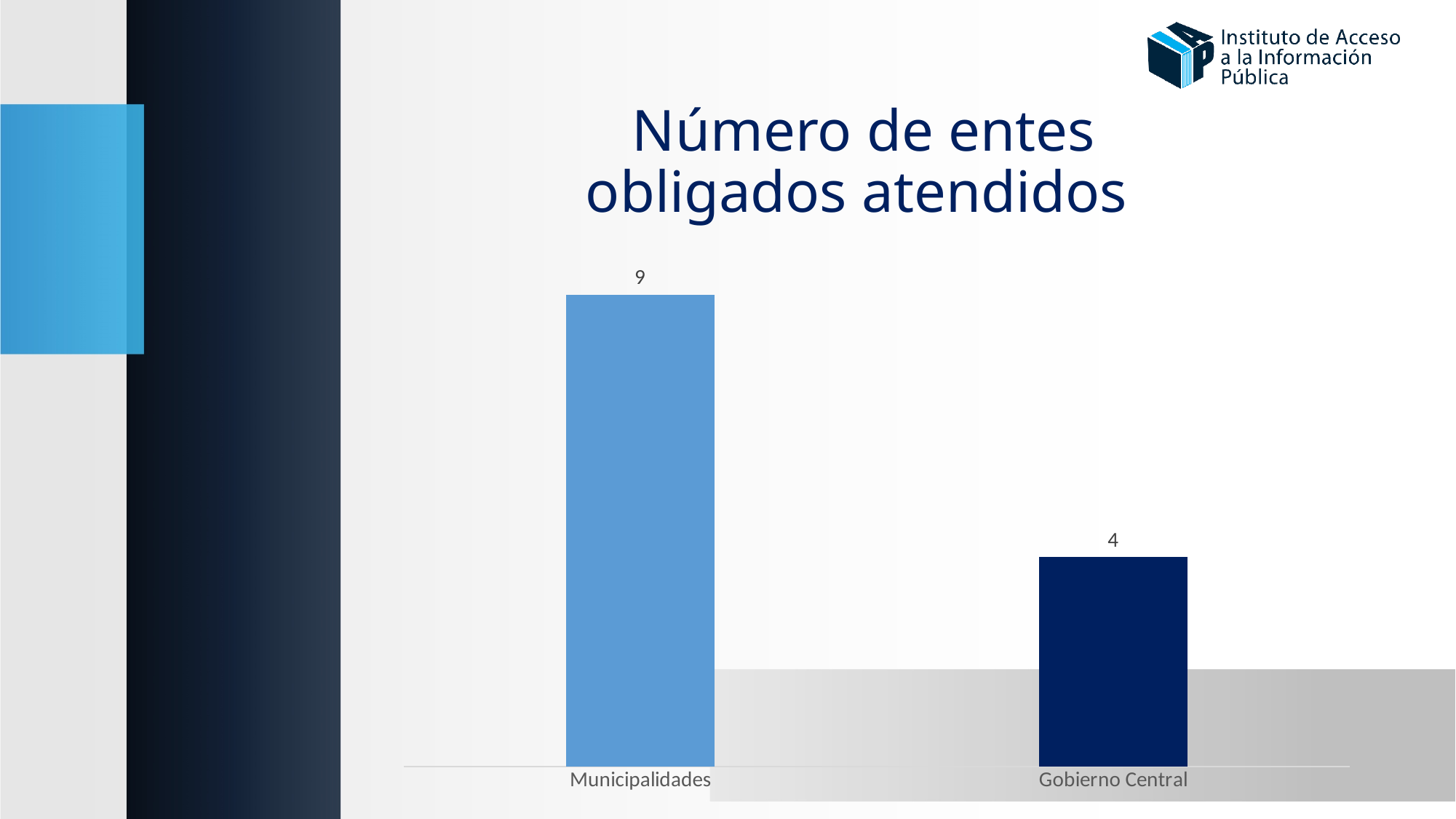
How many categories are shown in the chart? 2 What is the difference between the values for Municipalidades and Gobierno Central? 5 Which category has the lowest value? Gobierno Central Which is larger, the value for Municipalidades or the value for Gobierno Central? Municipalidades What is the value for Gobierno Central? 4 Which category has the highest value? Municipalidades What colour is the bar for Gobierno Central? Dark navy blue What kind of chart is shown on the slide? Bar chart What is the value for Municipalidades? 9 What is the title of the chart? Número de entes obligados atendidos